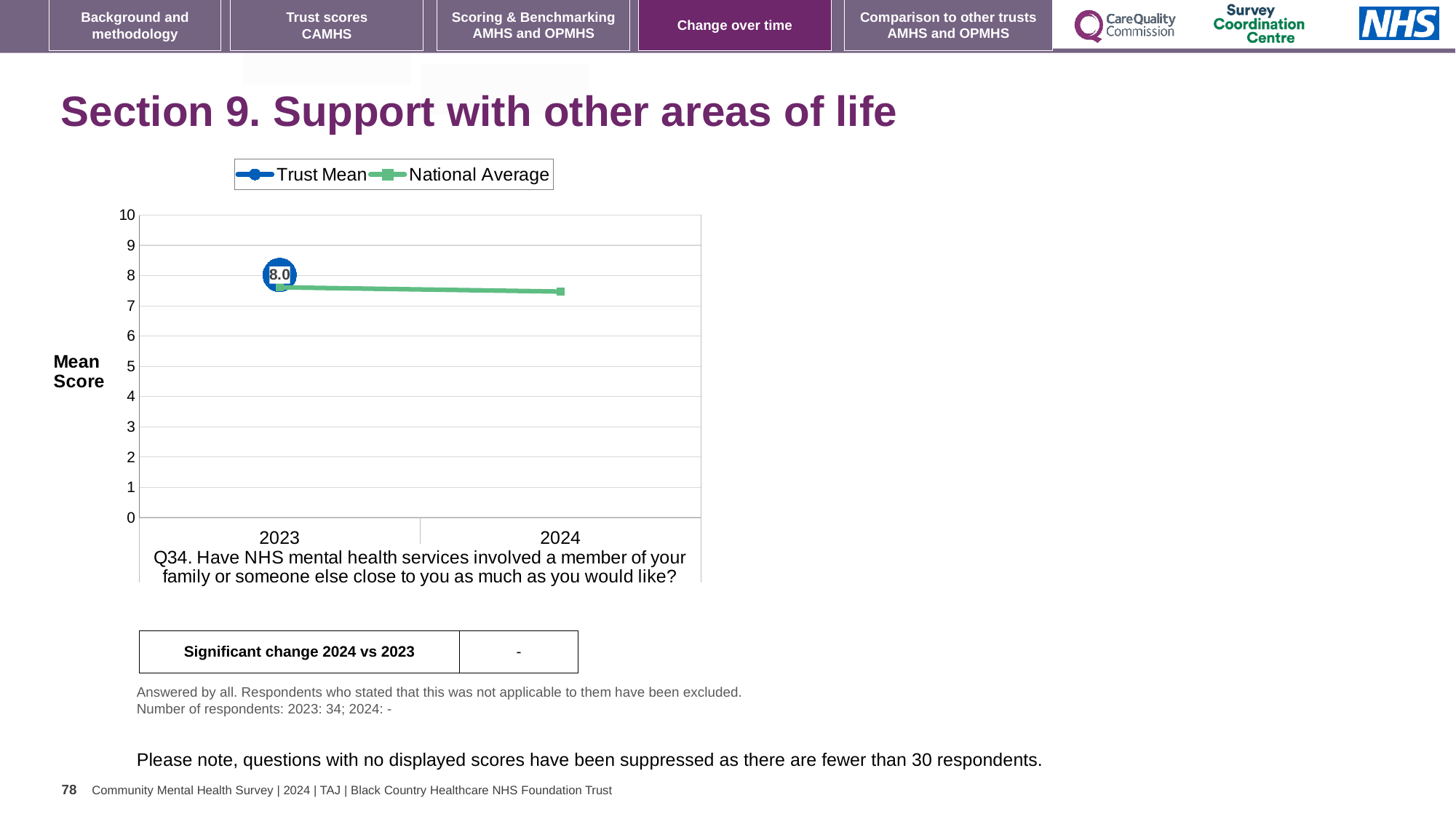
Is the National Average value for 2023 greater or less than 7? greater Is the Trust Mean value for 2023 greater or less than 7? greater How many series does the legend list? 2 What kind of chart is shown on the slide? line chart Is the National Average value for 2024 greater or less than 8? less Does the National Average rise or fall from 2023 to 2024? fall What is the Trust Mean score for 2023? 8.0 Which series is shown in green in the legend? National Average In 2023, which is larger: the Trust Mean or the National Average? Trust Mean What is the label on the y axis of the chart? Mean Score How many years are shown on the x axis? 2